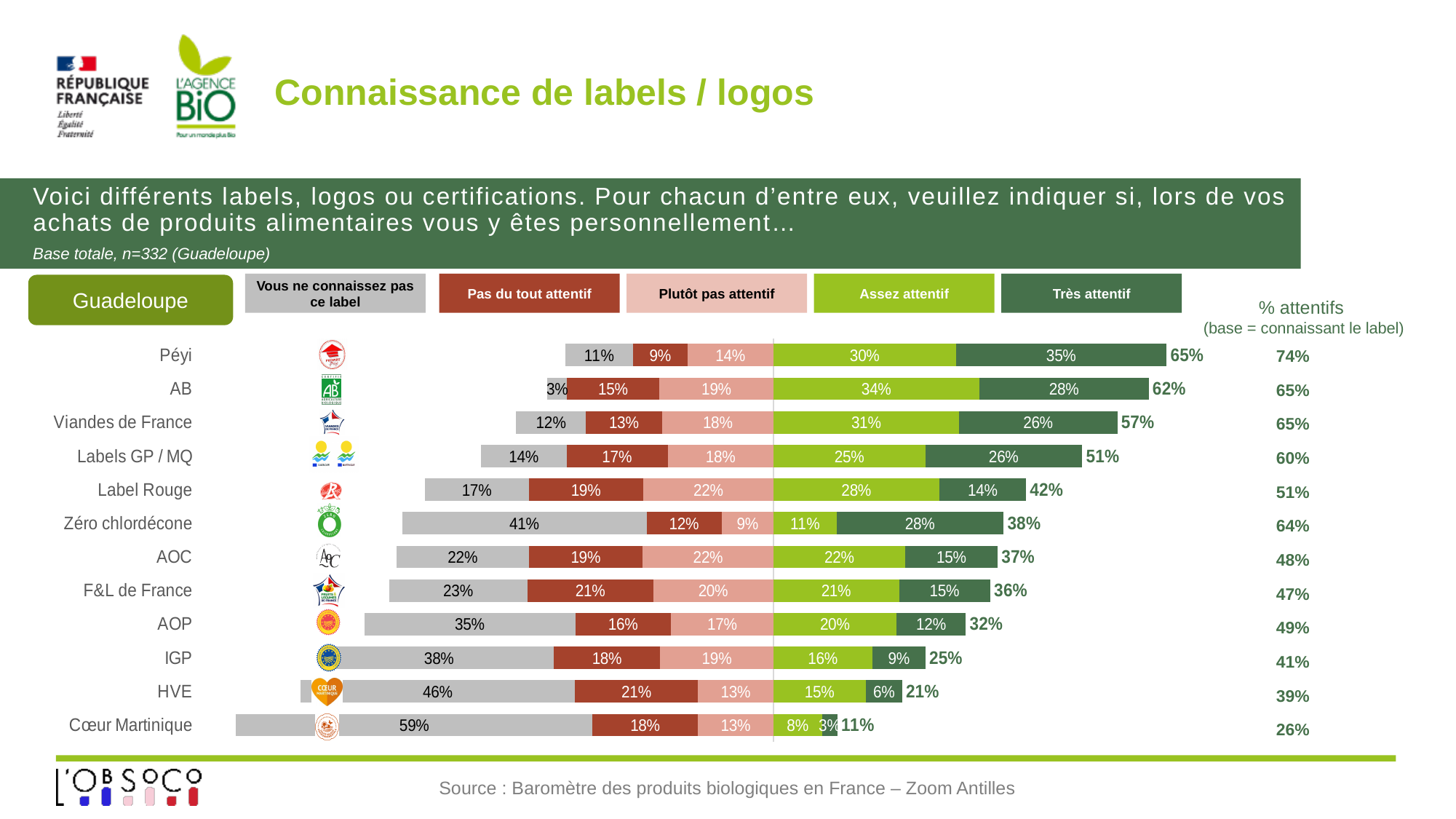
How many series does the legend list? 5 What is the "% attentifs" value shown for Zéro chlordécone? 64% What is the "Très attentif" value for Péyi? 35% What is the difference between the "Très attentif" values for Péyi and AB? 7 percentage points Which is larger: the "Assez attentif" value for Viandes de France or for Labels GP / MQ? Viandes de France What is the "Pas du tout attentif" value for Label Rouge? 19% What type of chart is shown on the slide? Stacked bar chart What is the "Assez attentif" value for AB? 34% What percentage of respondents say they do not know the Cœur Martinique label ("Vous ne connaissez pas ce label")? 59% Which label has the lowest "Très attentif" value? Cœur Martinique How many labels (categories) are shown in the chart? 12 Which label has the highest "Vous ne connaissez pas ce label" share? Cœur Martinique